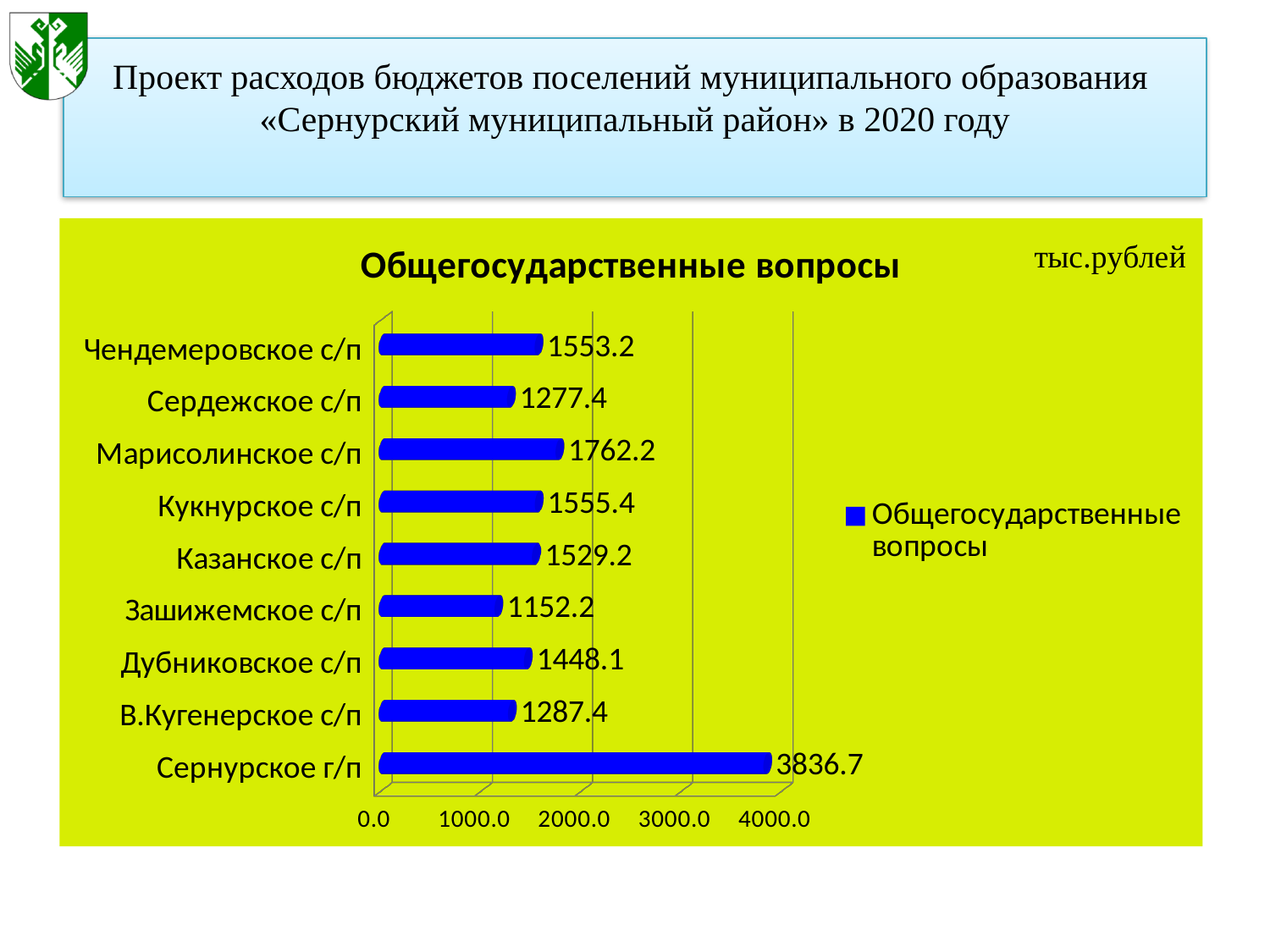
What is the difference between the values for Сернурское г/п and Марисолинское с/п? 2074.5 How many series does the legend list? 1 Which category has the lowest value? Зашижемское с/п Which is larger, the value for Марисолинское с/п or the value for Дубниковское с/п? Марисолинское с/п What is the value for Зашижемское с/п? 1152.2 What is the difference between the values for Чендемеровское с/п and Сердежское с/п? 275.8 What is the value for Сернурское г/п? 3836.7 Is the value for Сернурское г/п greater or less than 3000.0? greater What kind of chart is shown on the slide? bar chart What is the value for Марисолинское с/п? 1762.2 Which category has the highest value? Сернурское г/п How many categories are shown in the chart? 9